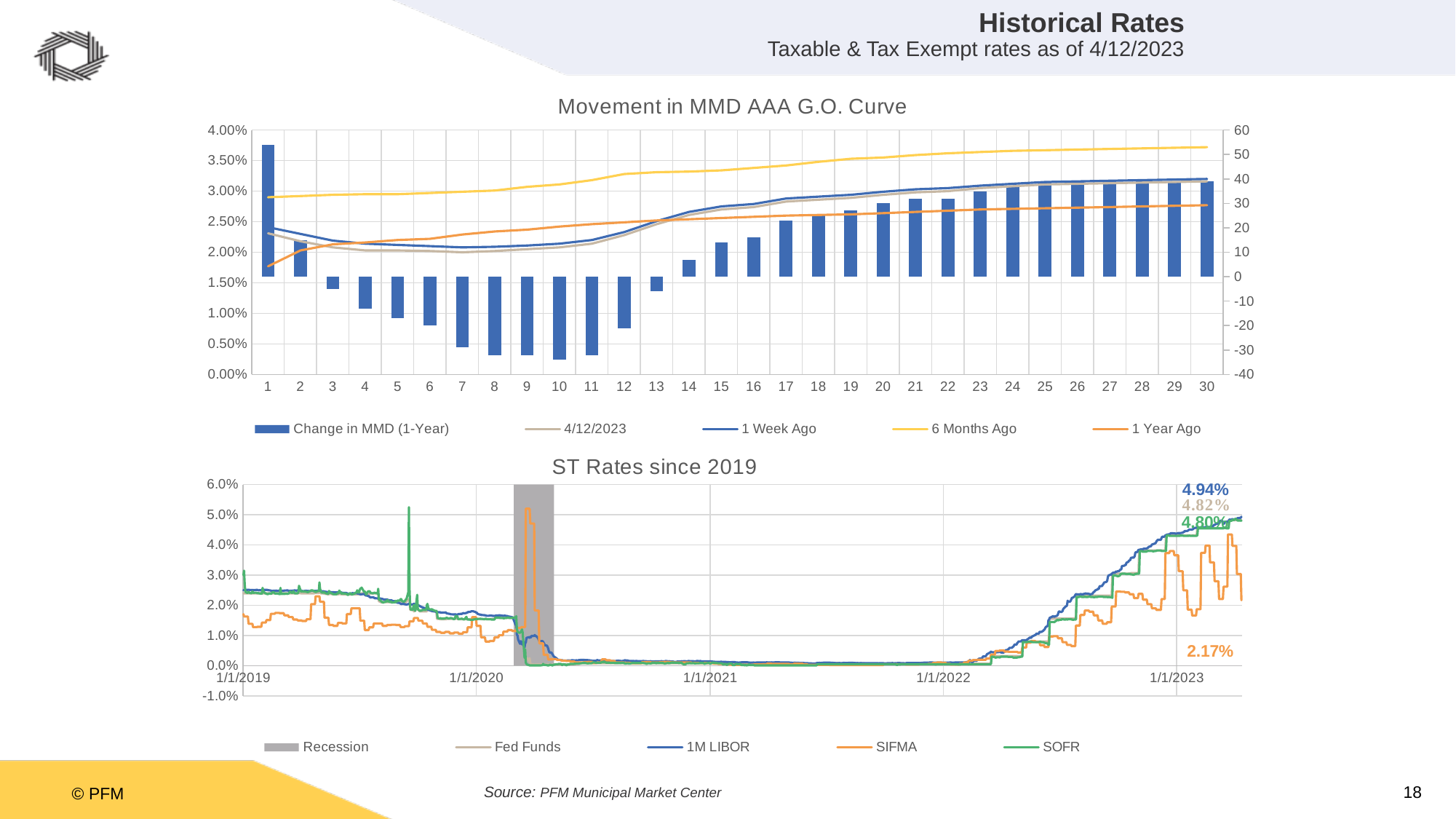
On the 'Movement in MMD AAA G.O. Curve' chart, how many series does the legend list? 5 On the 'ST Rates since 2019' chart, what is the labeled latest value for SIFMA? 2.17% On the 'ST Rates since 2019' chart, which labeled end value is larger, Fed Funds or SOFR? Fed Funds On the 'ST Rates since 2019' chart, what is the difference between the labeled 1M LIBOR value and the labeled SIFMA value? 2.77% What kind of chart is 'ST Rates since 2019'? line chart On the 'Movement in MMD AAA G.O. Curve' chart, is the Change in MMD (1-Year) bar at maturity 10 greater or less than 0? less On the 'Movement in MMD AAA G.O. Curve' chart, is the 1 Year Ago value at maturity 1 greater or less than 2.00%? less On the 'Movement in MMD AAA G.O. Curve' chart, does the 6 Months Ago line generally rise or fall from maturity 1 to maturity 30? rise On the 'ST Rates since 2019' chart, what is the labeled latest value for 1M LIBOR? 4.94% On the 'Movement in MMD AAA G.O. Curve' chart, is the 6 Months Ago value at maturity 1 greater or less than 2.50%? greater On the 'Movement in MMD AAA G.O. Curve' chart, how many maturity points are shown along the x axis? 30 On the 'Movement in MMD AAA G.O. Curve' chart, which line series is highest at maturity 30? 6 Months Ago